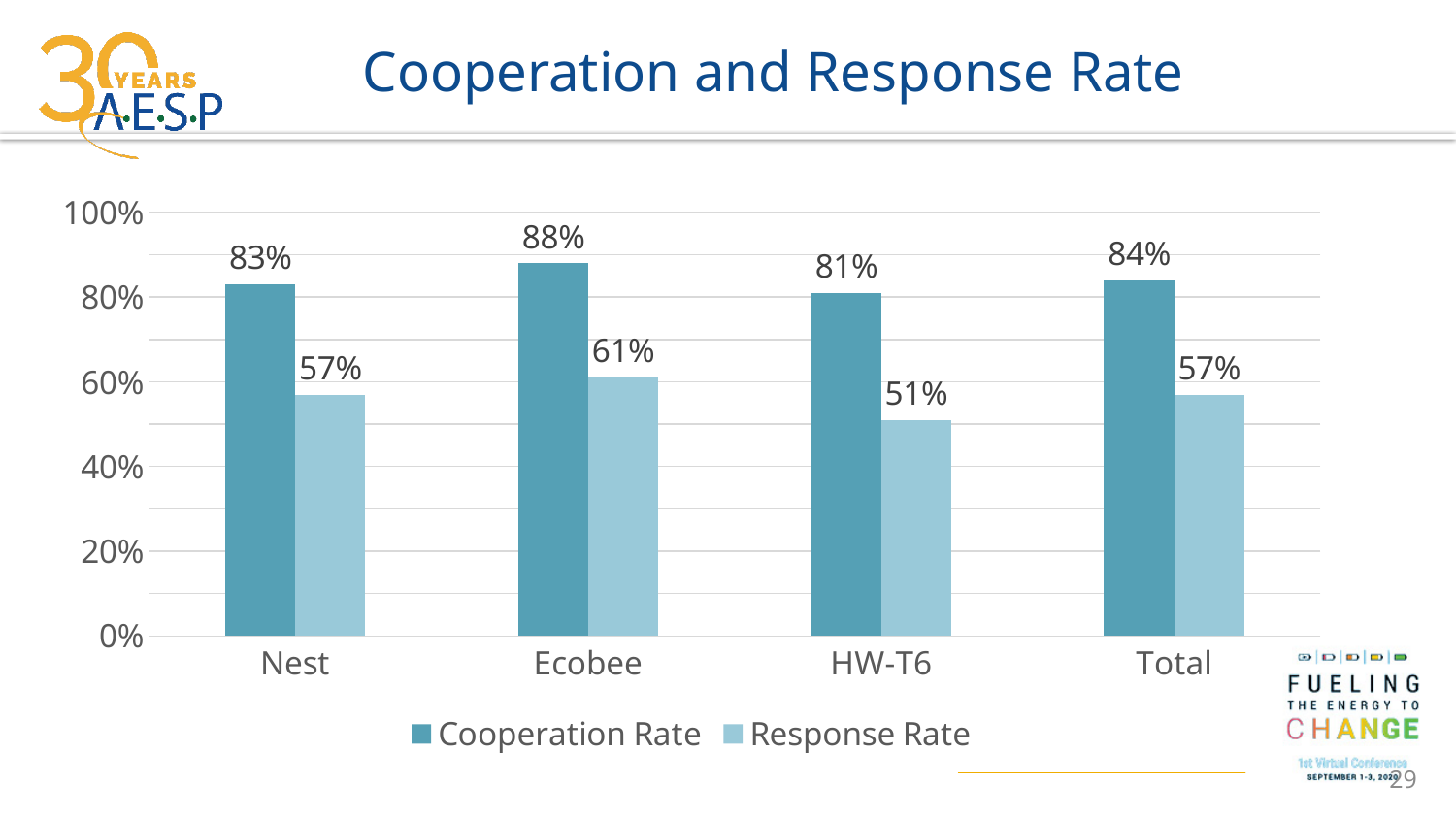
How many series does the legend list? 2 What is the difference between the Cooperation Rate and the Response Rate for Total? 27% What is the Response Rate for Nest? 57% How many categories are shown on the x axis? 4 What is the Response Rate for HW-T6? 51% Which category has the lowest Response Rate? HW-T6 What is the Cooperation Rate for Ecobee? 88% Is the Cooperation Rate for HW-T6 greater or less than 60%? greater What is the title of the chart? Cooperation and Response Rate What kind of chart is shown on the slide? Bar chart Which category has the highest Cooperation Rate? Ecobee Which is larger, the Response Rate for Ecobee or the Response Rate for Nest? Ecobee